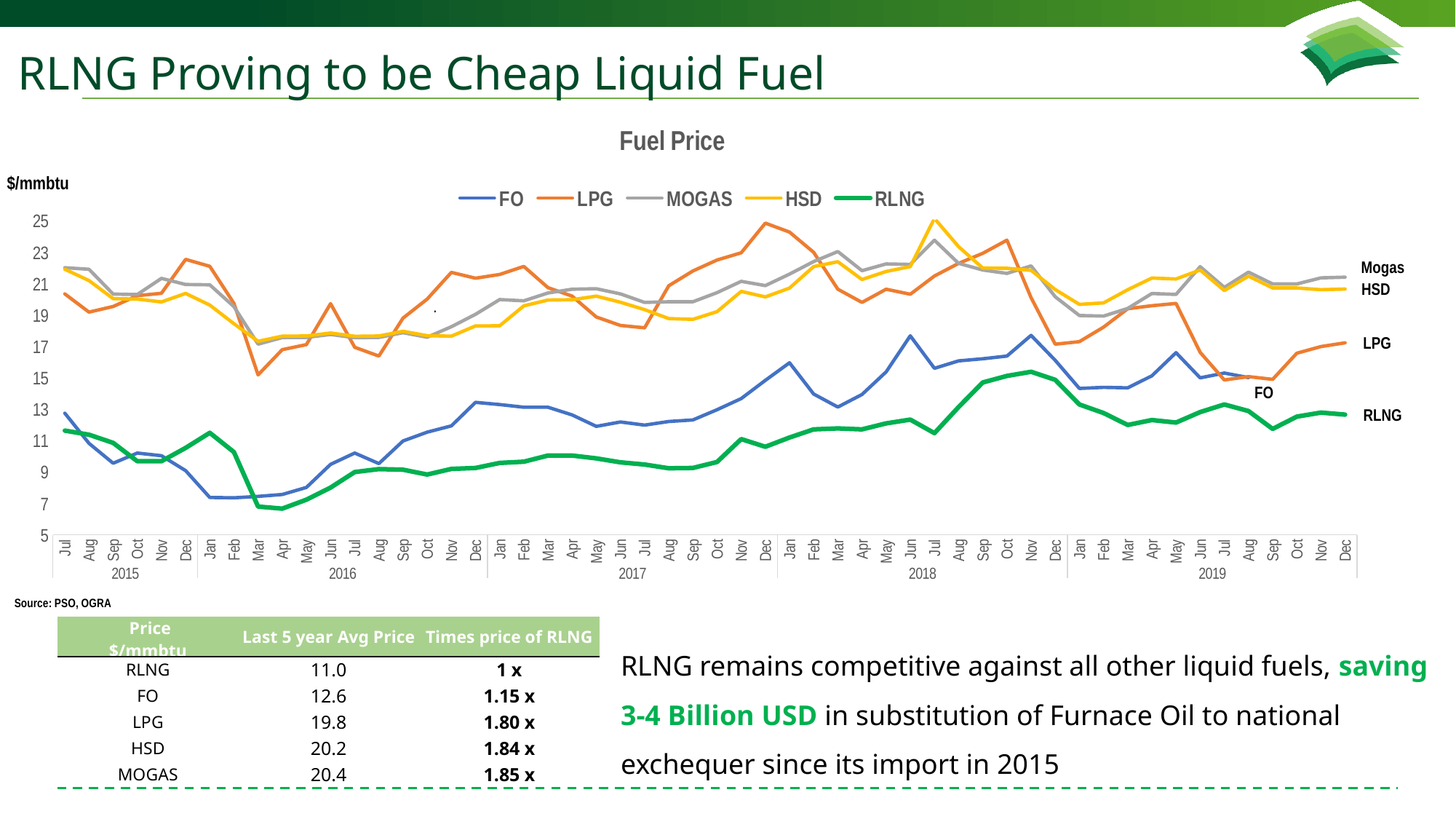
In Jan 2016, which is higher, FO or RLNG? RLNG What unit is shown on the vertical axis of the chart? $/mmbtu Is the FO value in Jan 2016 greater or less than 9? less Is the LPG value in Dec 2017 greater or less than 23? greater Which series has the lowest value in Dec 2019? RLNG Is the RLNG value in Jul 2015 greater or less than 11? greater What kind of chart is shown on the slide? Line chart What is the title of the chart? Fuel Price Does the FO line rise or fall from Jul 2015 to Jan 2016? Fall How many series does the legend of the Fuel Price chart list? 5